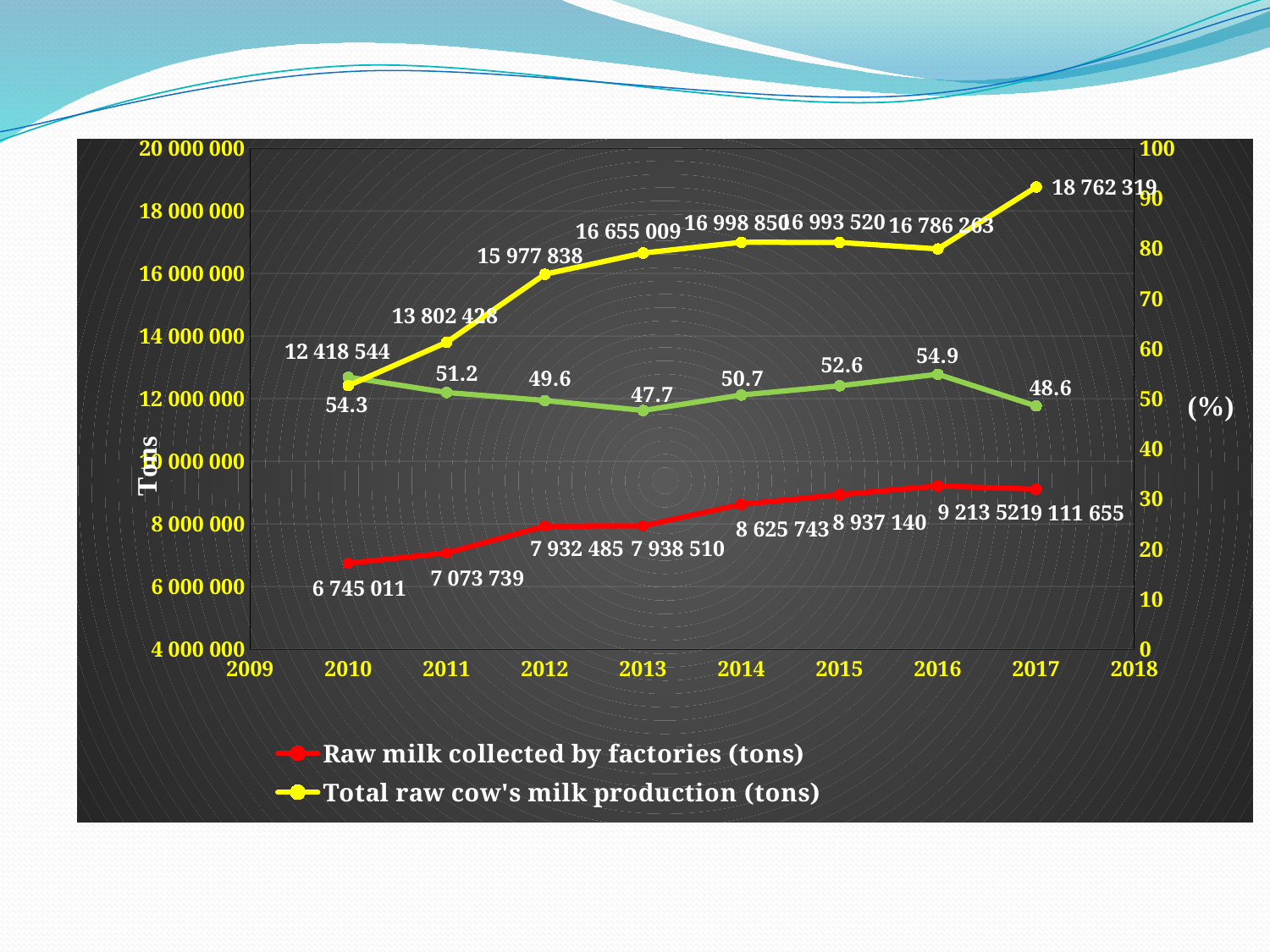
In which year was raw milk collected by factories lowest? 2010 In which year was total raw cow's milk production highest? 2017 What was the total raw cow's milk production (tons) in 2017? 18 762 319 What is the difference between total raw cow's milk production in 2017 and in 2010? 6 343 775 How many series does the legend list? 2 Is the total raw cow's milk production in 2012 greater or less than 14 000 000? greater What was the raw milk collected by factories (tons) in 2010? 6 745 011 What is the value of the green line in 2013? 47.7 Does raw milk collected by factories rise or fall from 2010 to 2016? rise Which year had more raw milk collected by factories, 2014 or 2015? 2015 What type of chart is shown on the slide? line chart How many years are plotted for each series? 8